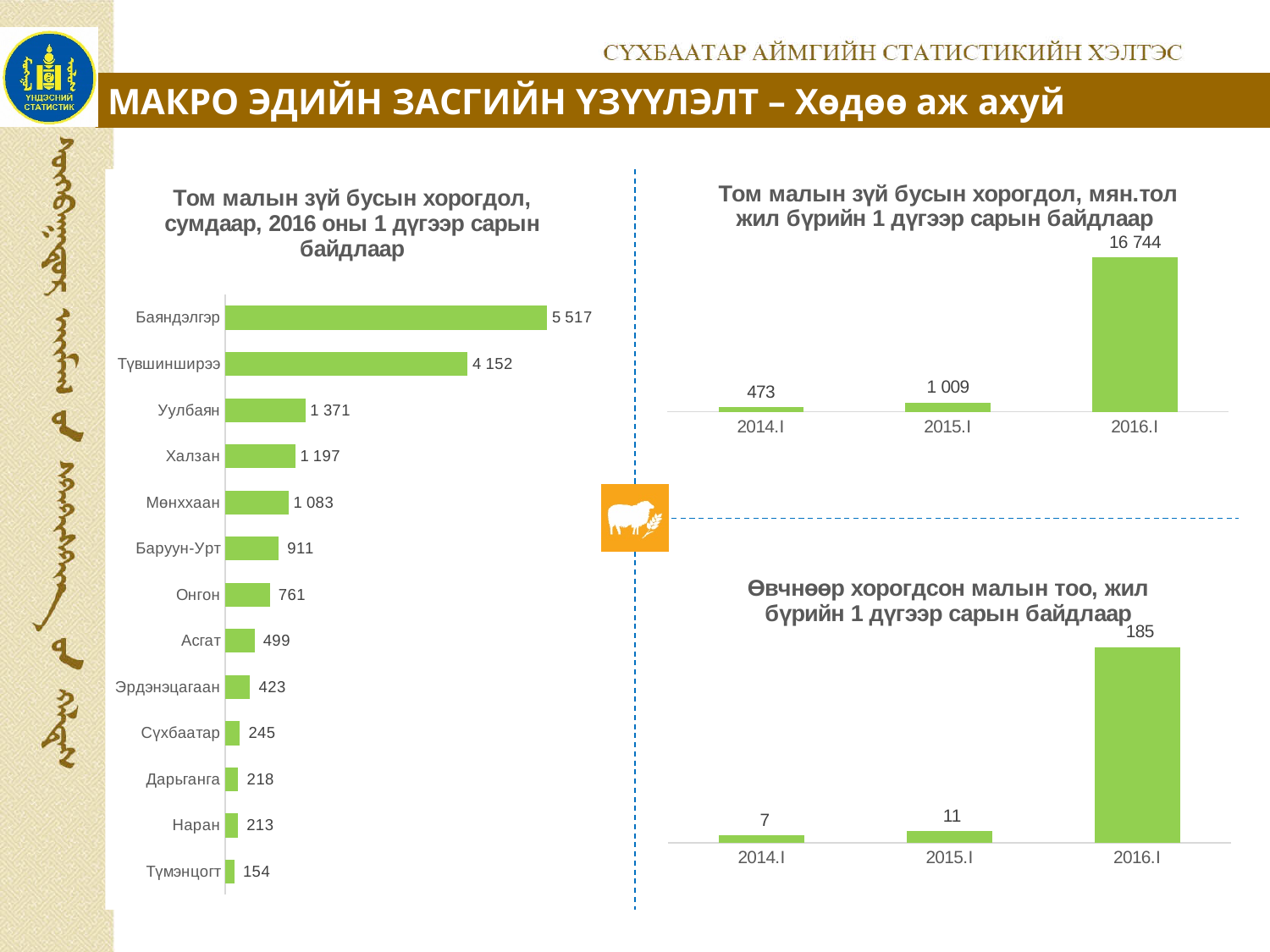
In the bottom right chart (Өвчнөөр хорогдсон малын тоо), what is the value for 2015.I? 11 In the left chart (Том малын зүй бусын хорогдол, сумдаар), what is the difference between Баяндэлгэр and Түвшинширээ? 1 365 In the top right chart (Том малын зүй бусын хорогдол, мян.тол), what is the difference between 2015.I and 2014.I? 536 In the left chart (Том малын зүй бусын хорогдол, сумдаар), which category has the lowest value? Түмэнцогт In the left chart (Том малын зүй бусын хорогдол, сумдаар), which is larger, Халзан or Мөнххаан? Халзан What kind of chart is the left chart (Том малын зүй бусын хорогдол, сумдаар)? Bar chart In the top right chart (Том малын зүй бусын хорогдол, мян.тол), what is the value for 2016.I? 16 744 In the bottom right chart (Өвчнөөр хорогдсон малын тоо), which year has the highest value? 2016.I In the left chart (Том малын зүй бусын хорогдол, сумдаар), how many categories are shown? 13 In the top right chart (Том малын зүй бусын хорогдол, мян.тол), do the values rise or fall from 2014.I to 2016.I? Rise In the left chart (Том малын зүй бусын хорогдол, сумдаар), what is the value for Онгон? 761 In the left chart (Том малын зүй бусын хорогдол, сумдаар), what is the value for Баяндэлгэр? 5 517